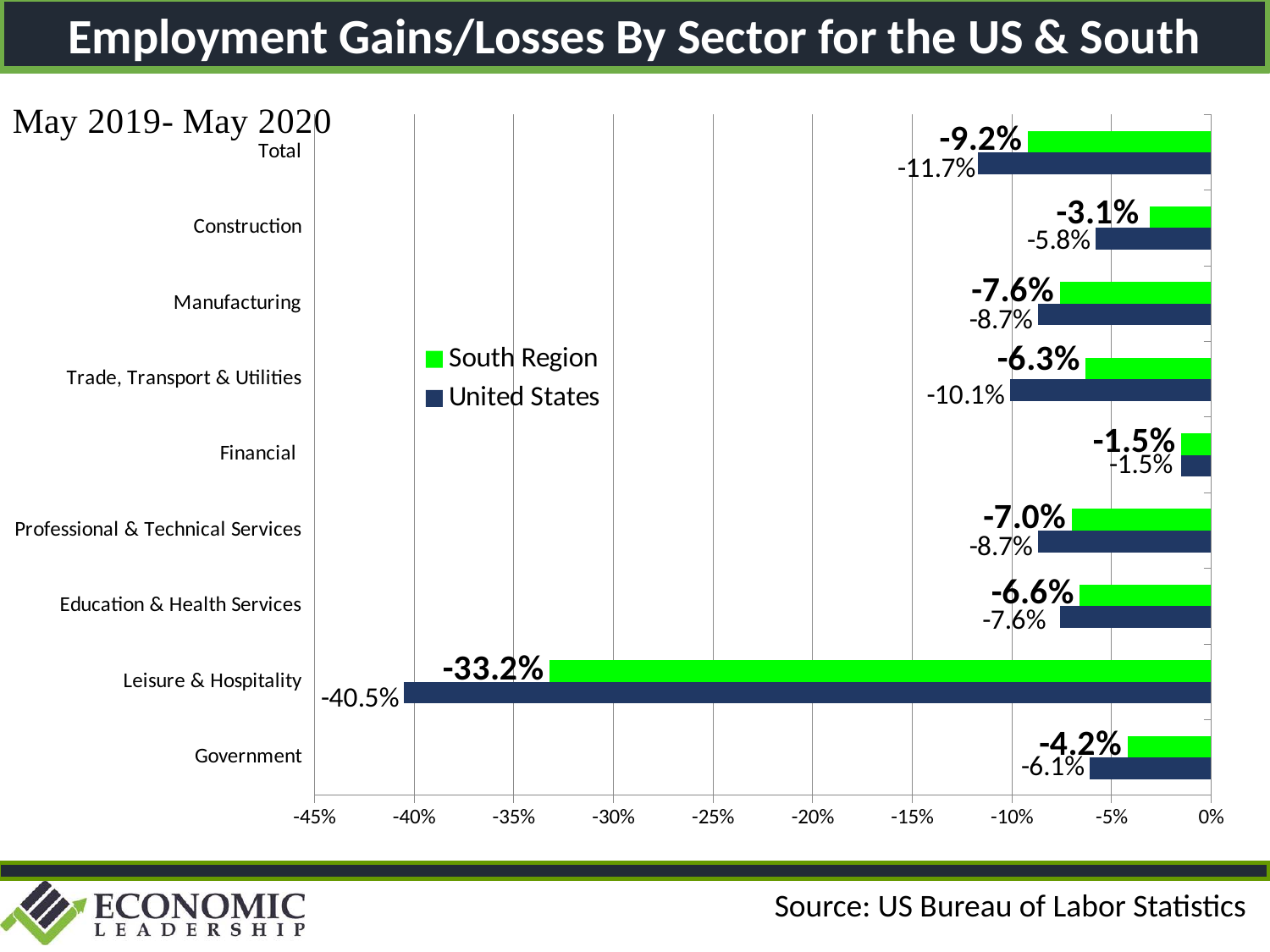
How many series does the legend list? 2 What is the difference in percentage points between the United States and South Region values for Leisure & Hospitality? 7.3 percentage points Which sector shows the largest employment loss for the United States? Leisure & Hospitality Which sector shows the smallest employment loss for the South Region? Financial What kind of chart is shown on the slide? Bar chart What is the United States value for Trade, Transport & Utilities? -10.1% Which colour represents the South Region in the legend? Green What is the United States value for Total? -11.7% What is the South Region value for Construction? -3.1% Which had a larger employment loss in Government, the South Region or the United States? United States How many sectors (categories) are shown on the chart? 9 What is the South Region value for Leisure & Hospitality? -33.2%